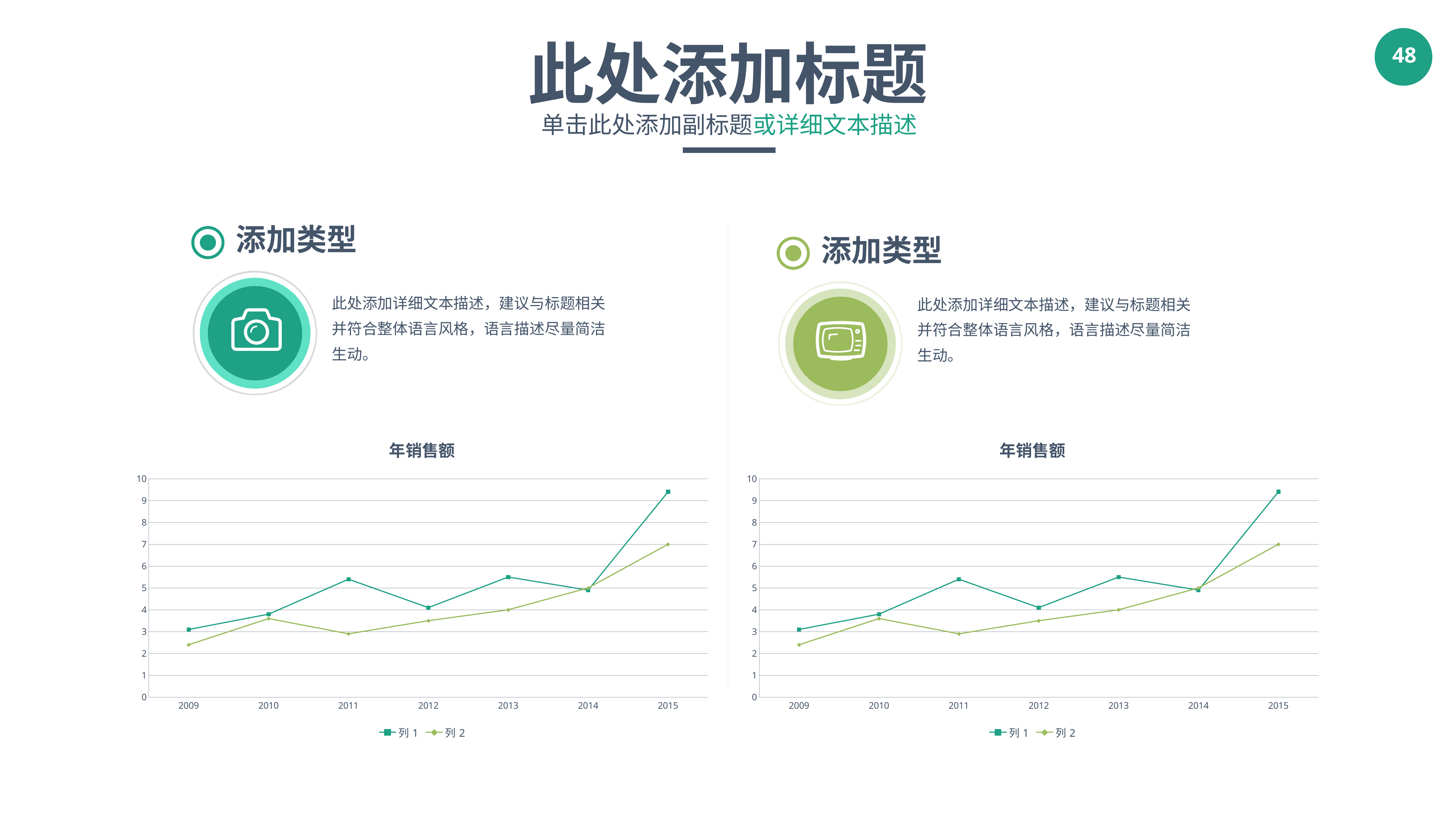
In the right chart, which year has the lowest value for 列 2? 2009 In the left chart, which year has the lowest value for 列 1? 2009 What is the title of the right chart? 年销售额 How many years are plotted along the x axis of the right chart? 7 In the right chart, is the value for 列 1 in 2011 greater or less than 5? greater What kind of chart is the left chart titled 年销售额? line chart In the right chart, is the value for 列 2 in 2009 greater or less than 3? less In the left chart, is the value for 列 1 in 2015 greater or less than 8? greater In the right chart, does the value for 列 2 overall rise or fall from 2009 to 2015? rise In the left chart, which series has the larger value in 2011, 列 1 or 列 2? 列 1 In the left chart, which year has the highest value for 列 1? 2015 How many series does the legend of the left chart list? 2